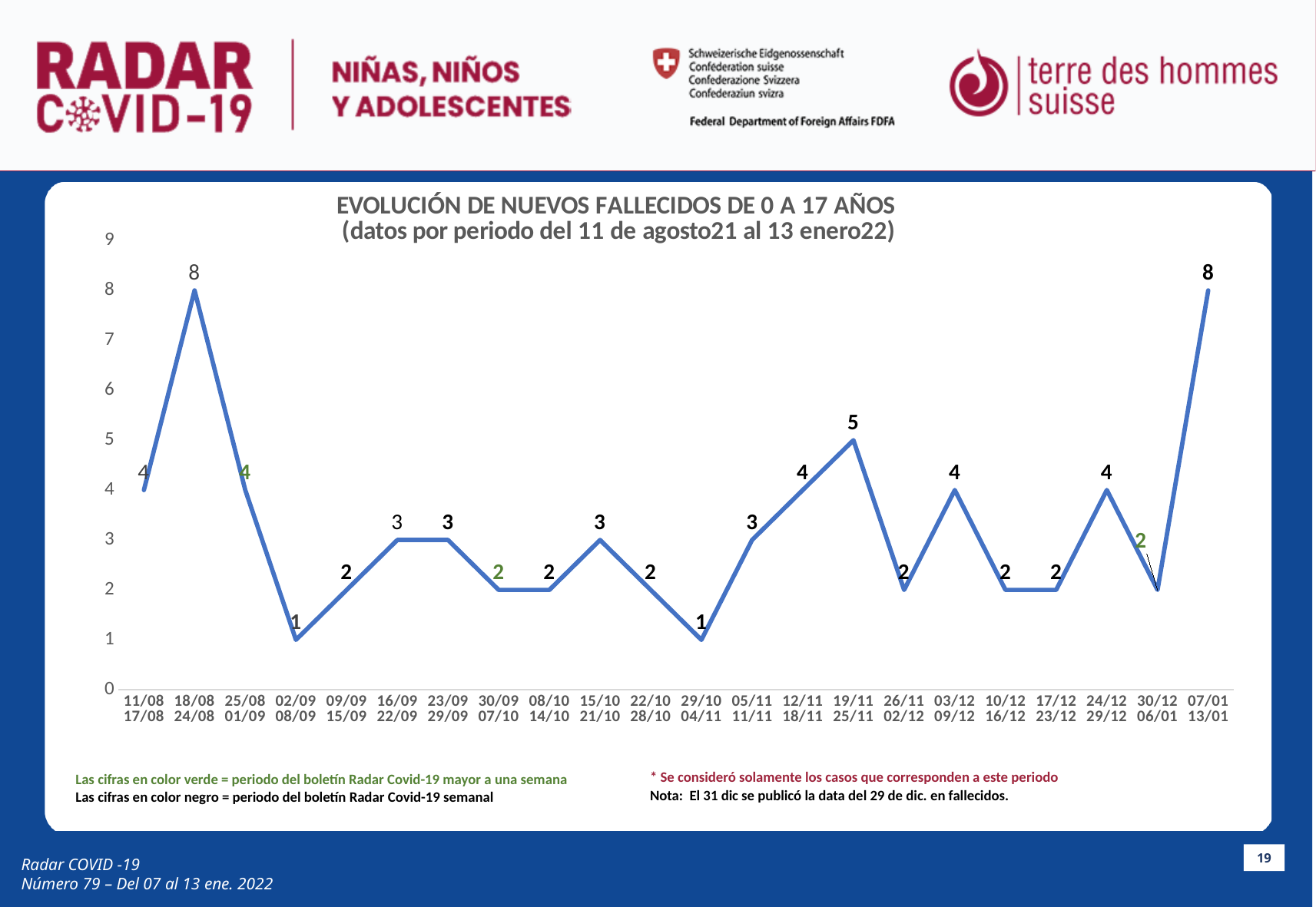
According to the note below the chart, what do the figures in green indicate? Periodo del boletín Radar Covid-19 mayor a una semana What is the value for the period 18/08-24/08? 8 Does the value rise or fall from the period 19/11-25/11 to the period 26/11-02/12? Fall What is the highest value plotted on the chart? 8 What is the value for the last period, 07/01-13/01? 8 What is the difference between the values for 07/01-13/01 and 30/12-06/01? 6 What is the difference between the values for 18/08-24/08 and 25/08-01/09? 4 Which period has the larger value, 05/11-11/11 or 12/11-18/11? 12/11-18/11 How many periods are plotted on the x axis? 22 What is the value for the period 02/09-08/09? 1 What kind of chart is shown on the slide? Line chart What is the value for the period 19/11-25/11? 5